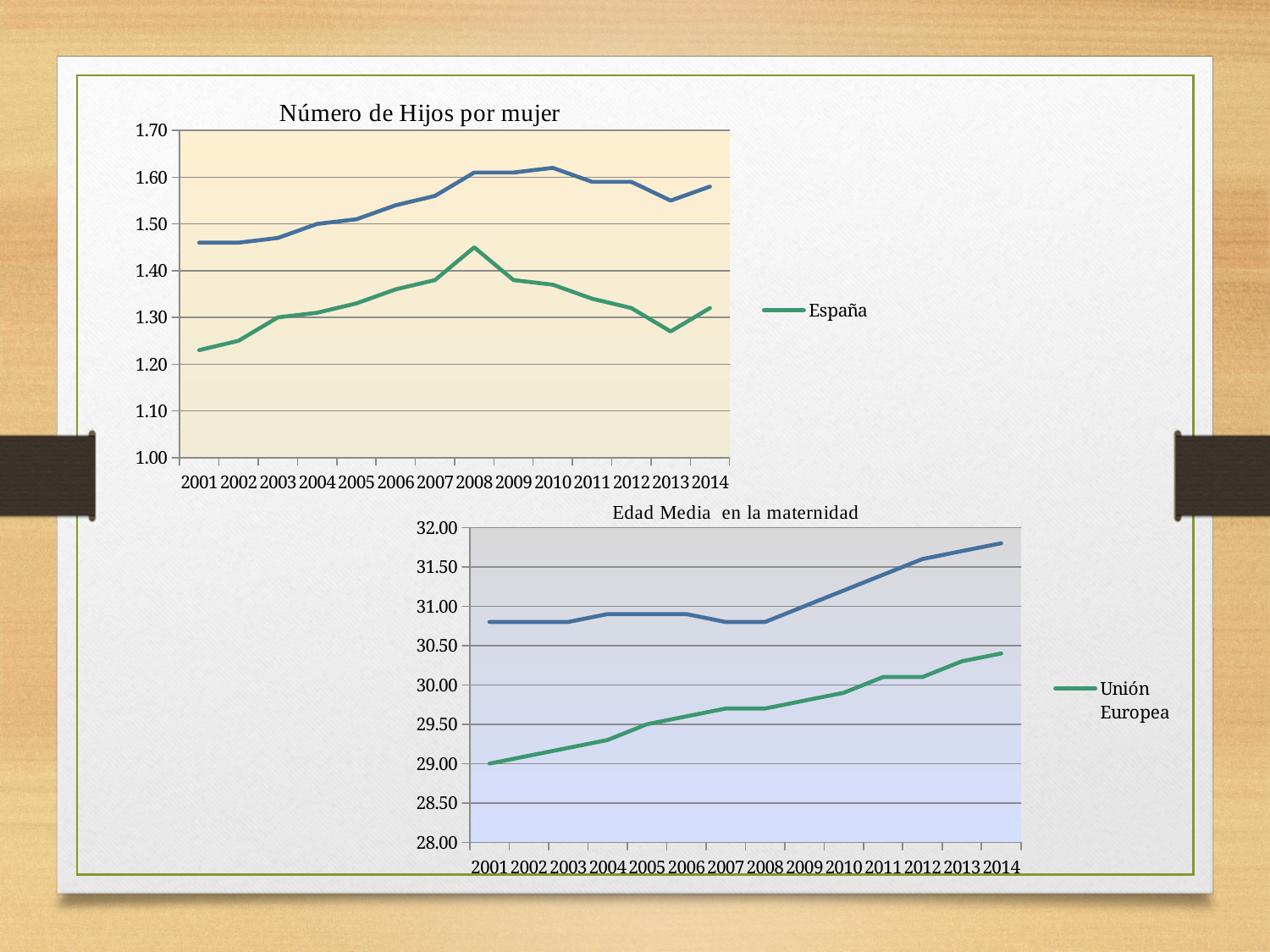
In the 'Edad Media en la maternidad' chart, is the value of the upper (blue) line for 2014 greater or less than 31.50? greater In the 'Número de Hijos por mujer' chart, how many years are shown on the x axis? 14 In the 'Número de Hijos por mujer' chart, in which year does the España line reach its highest value? 2008 In the 'Edad Media en la maternidad' chart, does the Unión Europea line generally rise or fall from 2001 to 2014? rise In the 'Edad Media en la maternidad' chart, is the Unión Europea value for 2014 greater or less than 30.00? greater In the 'Número de Hijos por mujer' chart, which is larger for España: the value in 2008 or the value in 2013? 2008 In the 'Edad Media en la maternidad' chart, in which year is the Unión Europea value highest? 2014 What is the title of the lower chart on the slide? Edad Media en la maternidad In the 'Número de Hijos por mujer' chart, is the España value for 2008 greater or less than 1.40? greater How many series does the legend of the 'Edad Media en la maternidad' chart list? 1 What type of chart is the 'Número de Hijos por mujer' chart? line chart